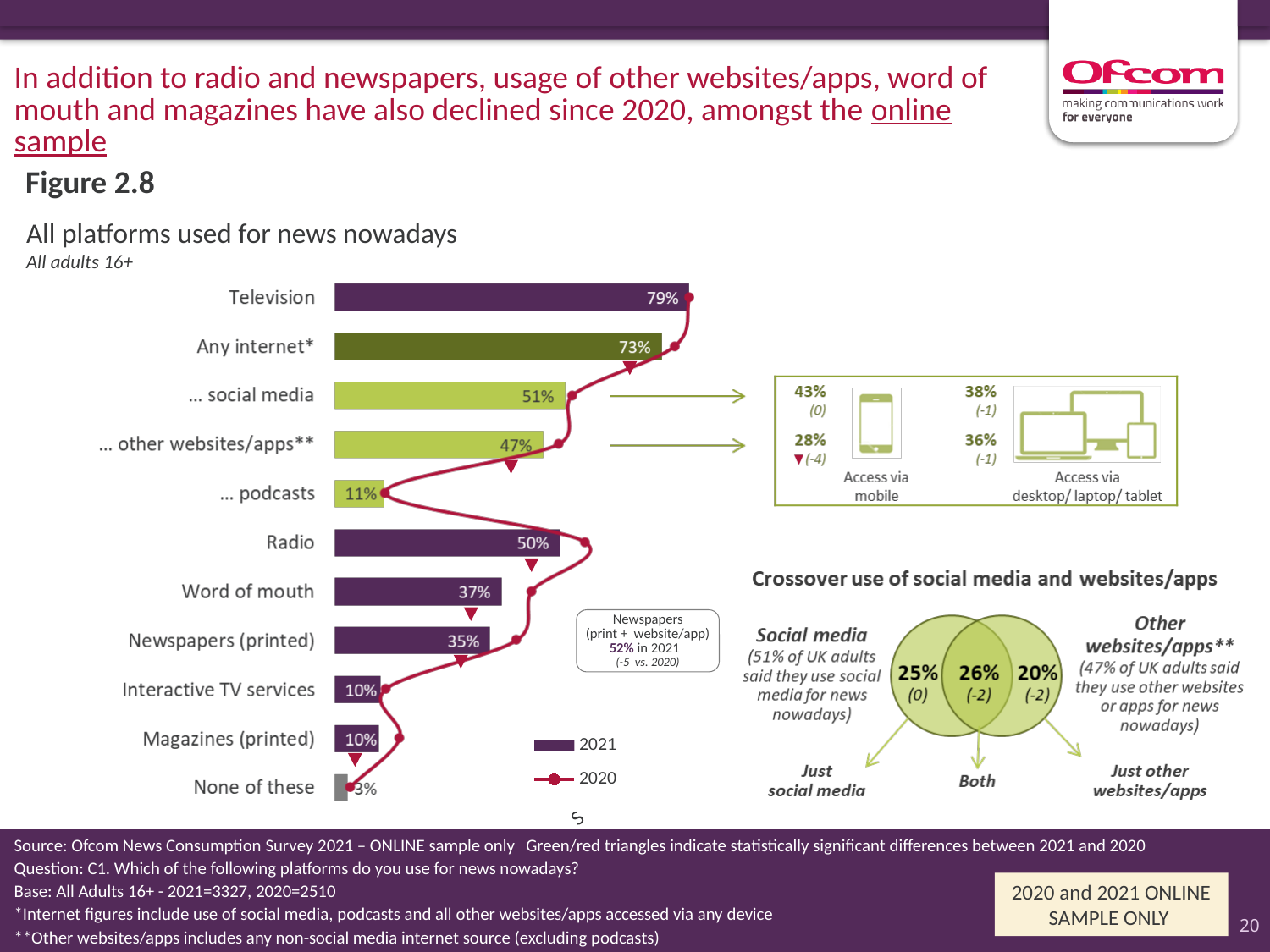
In the 'Crossover use of social media and websites/apps' diagram, what percentage use both social media and other websites/apps? 26% How many series does the legend of the 'All platforms used for news nowadays' chart list? 2 In the 'All platforms used for news nowadays' bar chart, what is the 2021 value for Television? 79% In the 'All platforms used for news nowadays' bar chart, which platform has the highest 2021 value? Television In the 'All platforms used for news nowadays' bar chart, what is the difference between the 2021 values for social media and other websites/apps? 4 percentage points In the 'Access via mobile' box, what percentage is shown for social media access via mobile (top value)? 43% In the 'All platforms used for news nowadays' bar chart, what is the 2021 value for Radio? 50% In the 'All platforms used for news nowadays' bar chart, which category has the lowest 2021 value? None of these In the 'All platforms used for news nowadays' bar chart, which has a higher 2021 value: Radio or Newspapers (printed)? Radio What type of chart is used for 'All platforms used for news nowadays'? Bar chart How many platform categories are shown in the 'All platforms used for news nowadays' bar chart? 11 In the 'All platforms used for news nowadays' bar chart, what is the 2021 value for Word of mouth? 37%